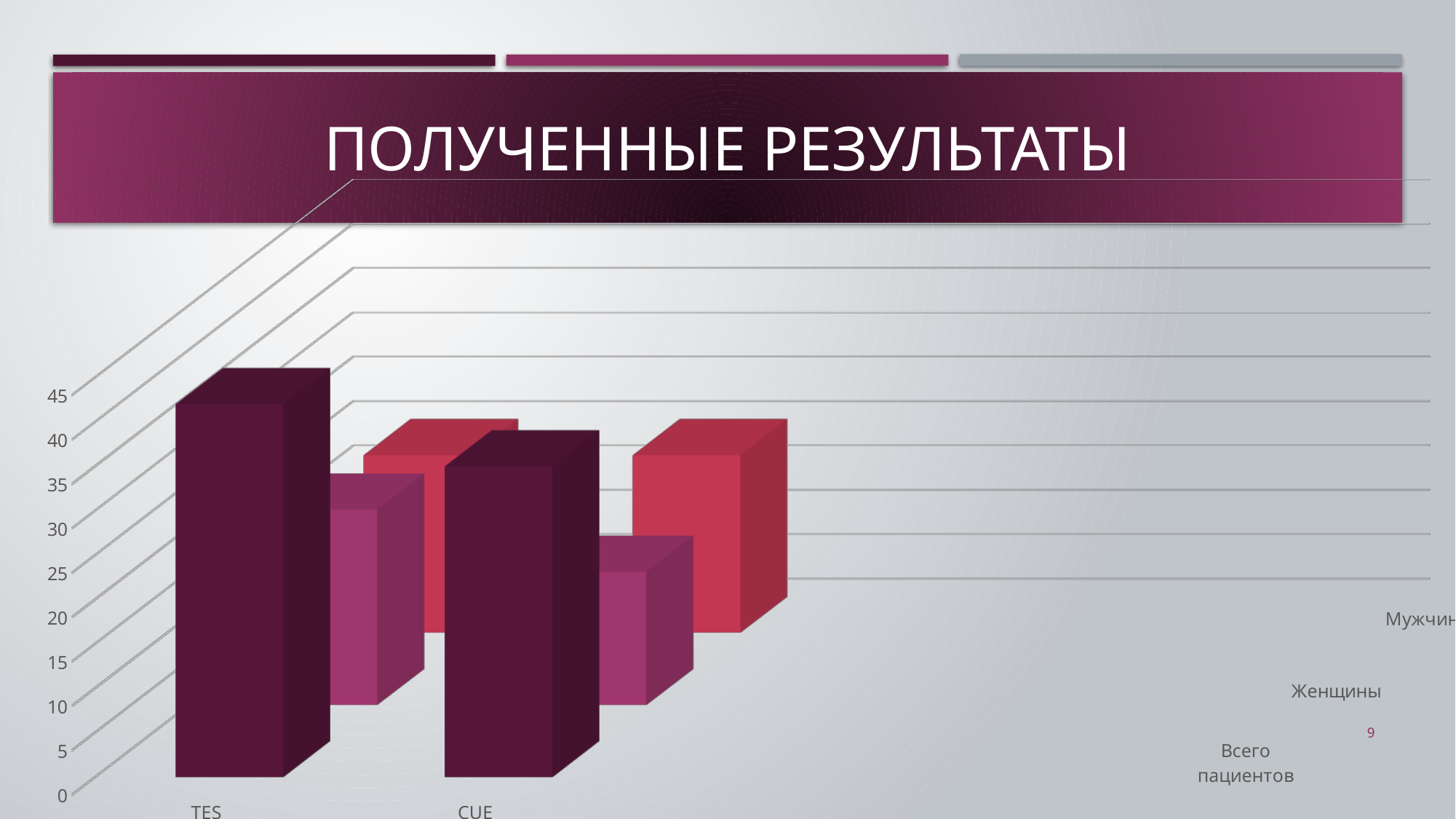
Does the value for Всего пациентов rise or fall from TES to CUE? fall Is the value for Всего пациентов in CUE greater or less than 30? greater What is the highest value shown on the vertical axis of the chart? 45 In the TES category, which is larger: Всего пациентов or Женщины? Всего пациентов What are the two categories on the x axis of the chart? TES and CUE Is the value for Всего пациентов in TES greater or less than 40? greater How many categories are shown along the x axis of the chart? 2 Is the value for Всего пациентов in CUE greater or less than 40? less What is the title of the slide containing the chart? Полученные результаты Which category has the higher value for Всего пациентов, TES or CUE? TES Which category has the higher value for Женщины, TES or CUE? TES What kind of chart is shown on the slide? 3D bar chart